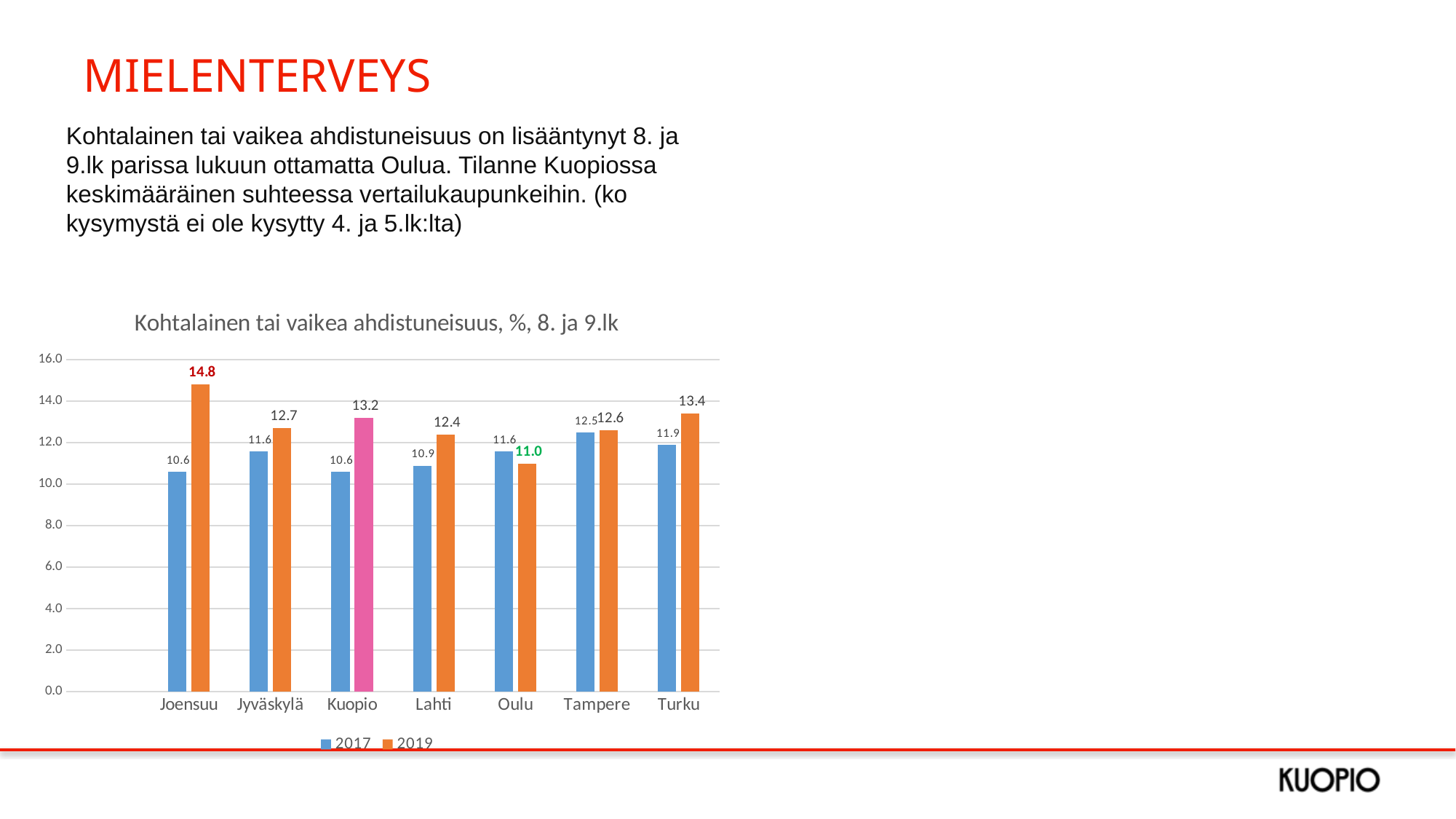
What is the 2017 value for Kuopio? 10.6 What kind of chart is shown? bar chart Which city has the lowest 2019 value? Oulu What is the 2019 value for Joensuu? 14.8 Which is larger for Oulu, the 2017 value or the 2019 value? 2017 How many cities are shown on the x axis? 7 What is the difference between the 2019 and 2017 values for Kuopio? 2.6 Which city has the highest 2019 value? Joensuu What is the title of the chart? Kohtalainen tai vaikea ahdistuneisuus, %, 8. ja 9.lk Is the 2019 value for Turku greater or less than 12.0? greater How many series does the legend list? 2 What is the 2019 value for Oulu? 11.0